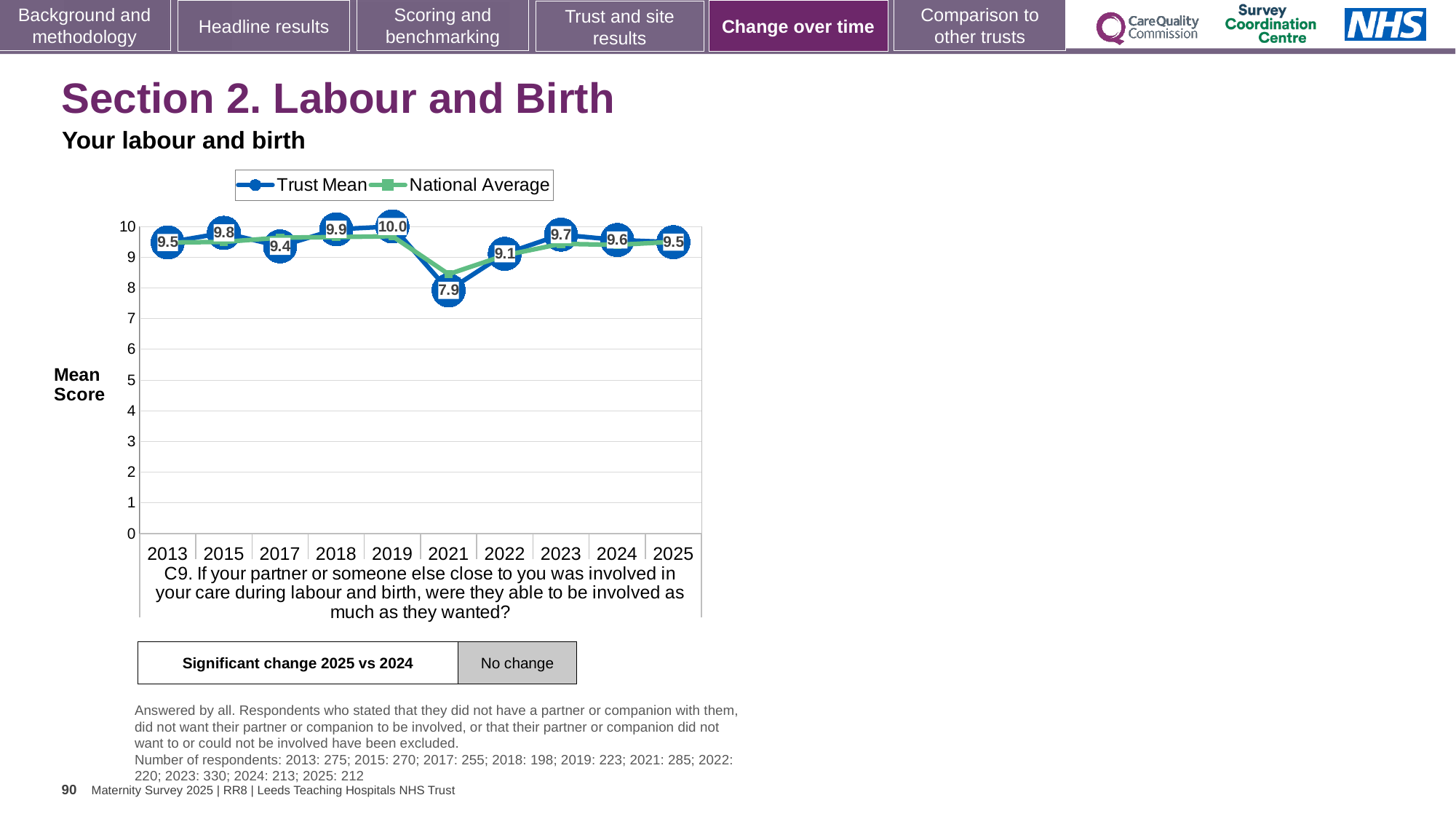
What kind of chart is shown on the slide? Line chart What is the Trust Mean score for 2019? 10.0 What is the Trust Mean score for 2021? 7.9 How many series does the chart legend list? 2 In which year is the Trust Mean score the highest? 2019 Which year has a higher Trust Mean score, 2015 or 2022? 2015 How many years are shown on the x axis of the chart? 10 What is the Trust Mean score for 2025? 9.5 What is the Trust Mean score for 2018? 9.9 What is the difference between the Trust Mean scores for 2019 and 2021? 2.1 Is the National Average for 2021 greater or less than 9? less In which year is the Trust Mean score the lowest? 2021